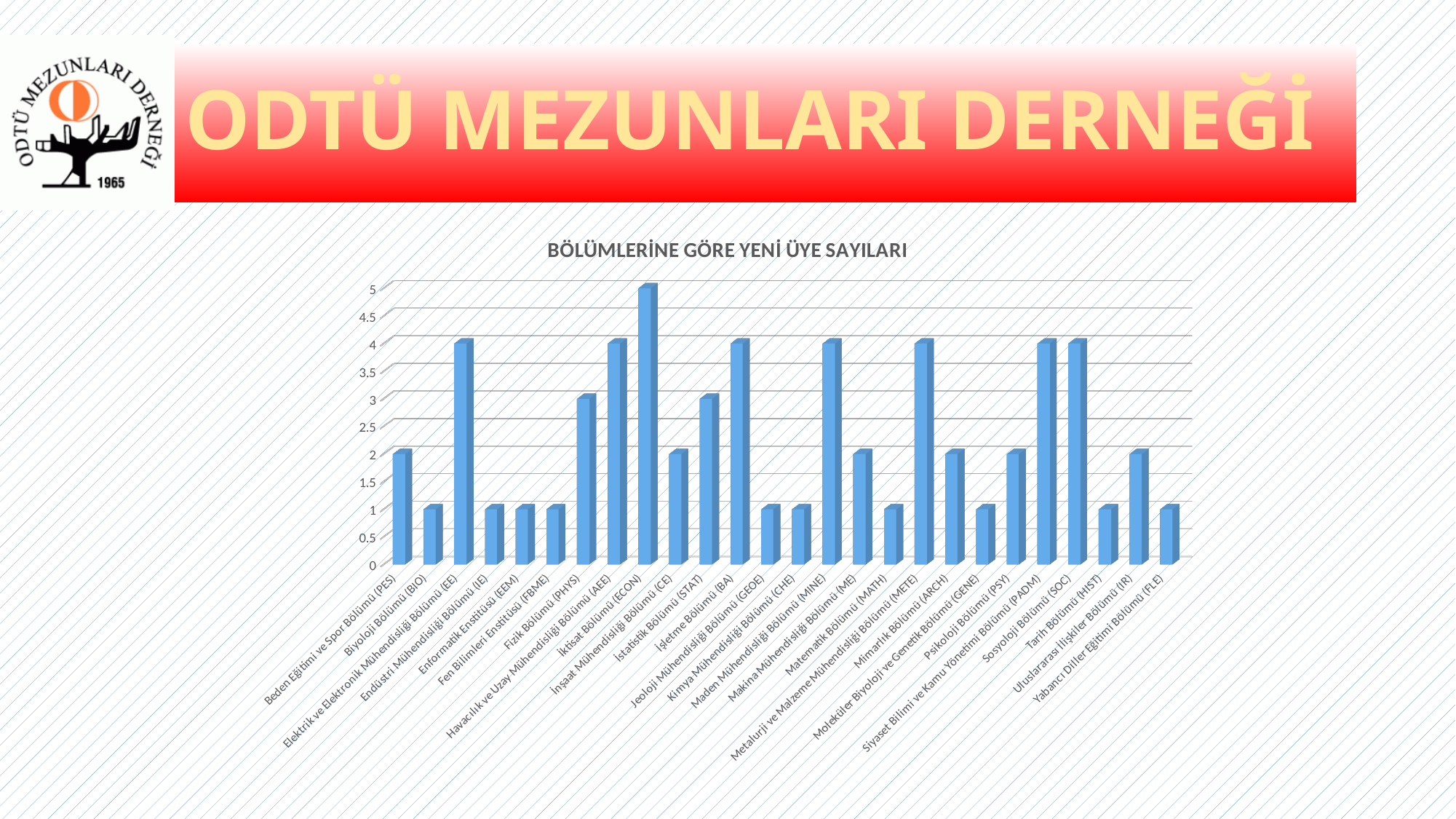
What is the title of the chart? BÖLÜMLERİNE GÖRE YENİ ÜYE SAYILARI What is the value for Fizik Bölümü (PHYS)? 3 What is the value for İktisat Bölümü (ECON)? 5 What kind of chart is shown on the slide? bar chart What is the value for Beden Eğitimi ve Spor Bölümü (PES)? 2 What is the difference between the values for İktisat Bölümü (ECON) and İstatistik Bölümü (STAT)? 2 How many departments are shown on the x axis? 26 Which department has the highest number of new members? İktisat Bölümü (ECON) What is the value for Sosyoloji Bölümü (SOC)? 4 Which is larger, the value for Makina Mühendisliği Bölümü (ME) or the value for Mimarlık Bölümü (ARCH)? Neither; they are equal (both 2) What is the lowest value shown on the chart? 1 Is the value for Elektrik ve Elektronik Mühendisliği Bölümü (EE) greater or less than 3? greater